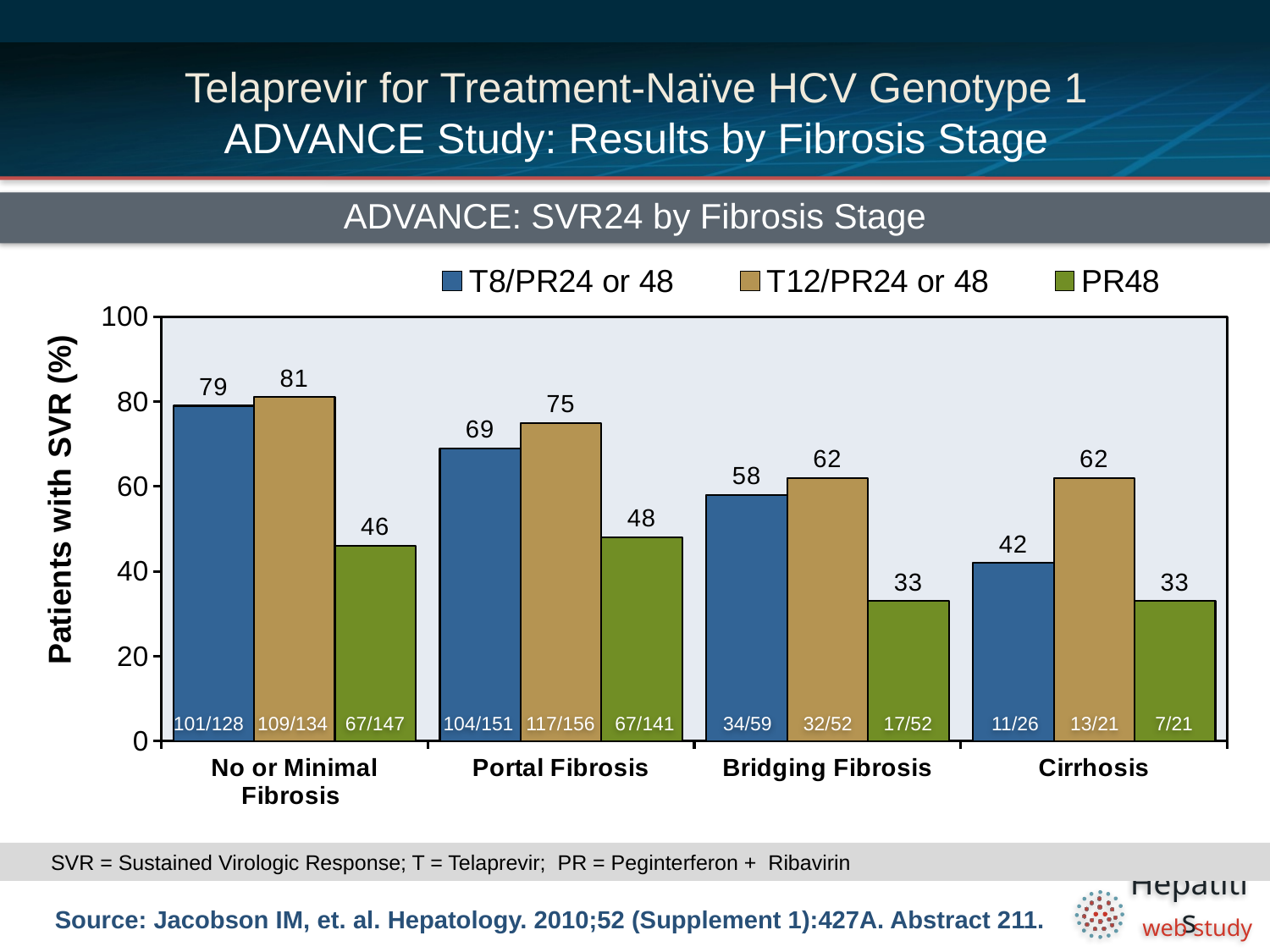
How many series does the legend list? 3 Which fibrosis stage has the lowest SVR rate for T12/PR24 or 48? Bridging Fibrosis and Cirrhosis (both 62) What kind of chart is shown on the slide? Bar chart What is the difference between the T12/PR24 or 48 and PR48 SVR rates in the Bridging Fibrosis group? 29 What fraction is printed inside the PR48 bar for the Cirrhosis group? 7/21 How does the SVR rate for T8/PR24 or 48 change across the fibrosis stages from left to right? It falls What is the SVR rate for PR48 in the No or Minimal Fibrosis group? 46 How many fibrosis stage categories are shown on the x axis? 4 What is the SVR rate for T8/PR24 or 48 in the Cirrhosis group? 42 Which fibrosis stage has the highest SVR rate for T8/PR24 or 48? No or Minimal Fibrosis What is the SVR rate for T12/PR24 or 48 in the Portal Fibrosis group? 75 Which is larger in the Cirrhosis group: the SVR rate for T8/PR24 or 48 or for PR48? T8/PR24 or 48